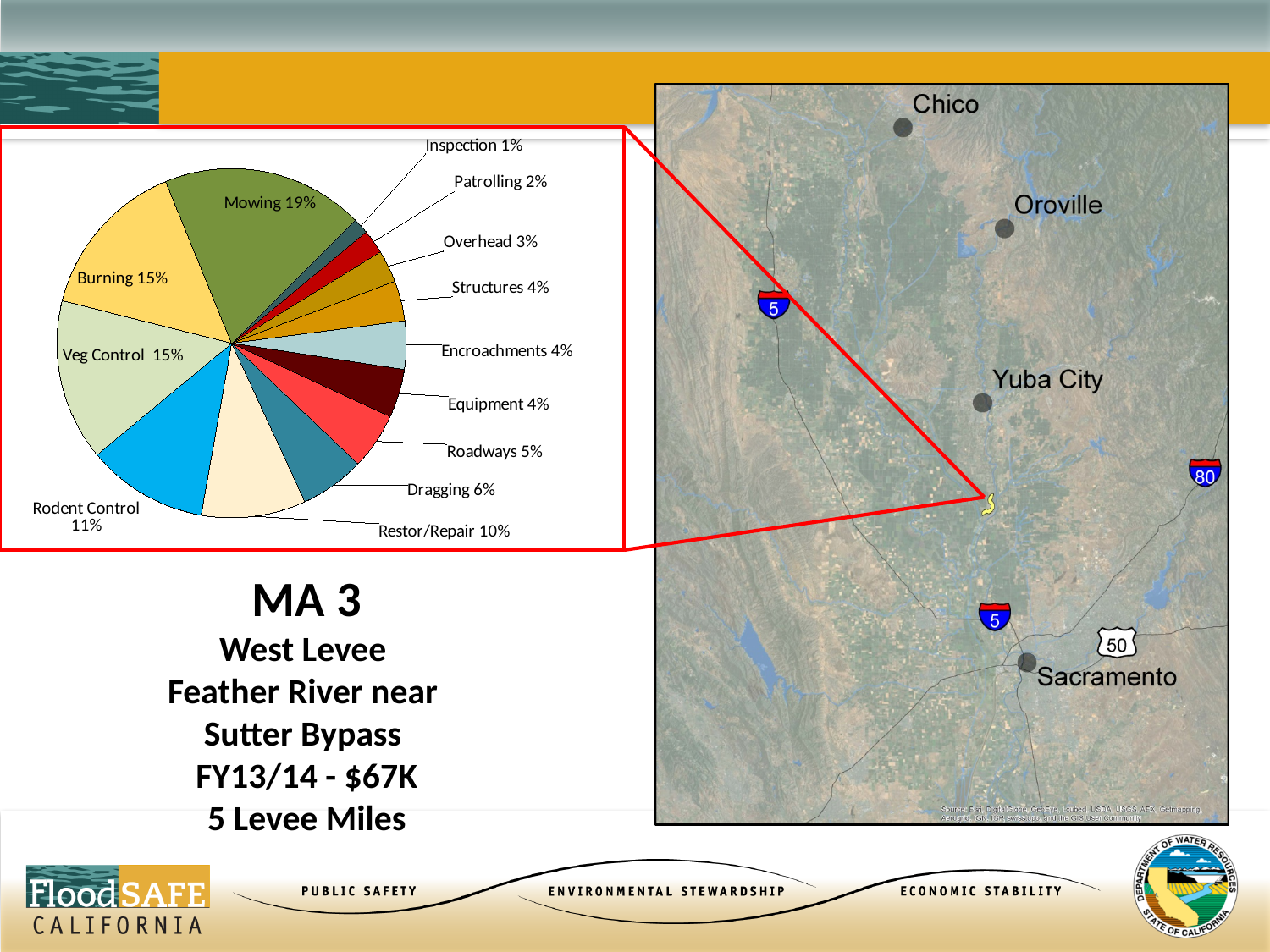
What share of the pie does Mowing represent? 19% What kind of chart is shown on the slide? pie chart What is the value shown for Restor/Repair? 10% What is the value shown for Overhead? 3% What is the difference in percentage points between Roadways and Patrolling? 3 Which category has the largest slice of the pie? Mowing Which is larger, Rodent Control or Restor/Repair? Rodent Control What is the value shown for Rodent Control? 11% Which category has the smallest slice of the pie? Inspection What is the value shown for Dragging? 6% How many categories are shown in the pie chart? 13 What is the difference in percentage points between Mowing and Burning? 4